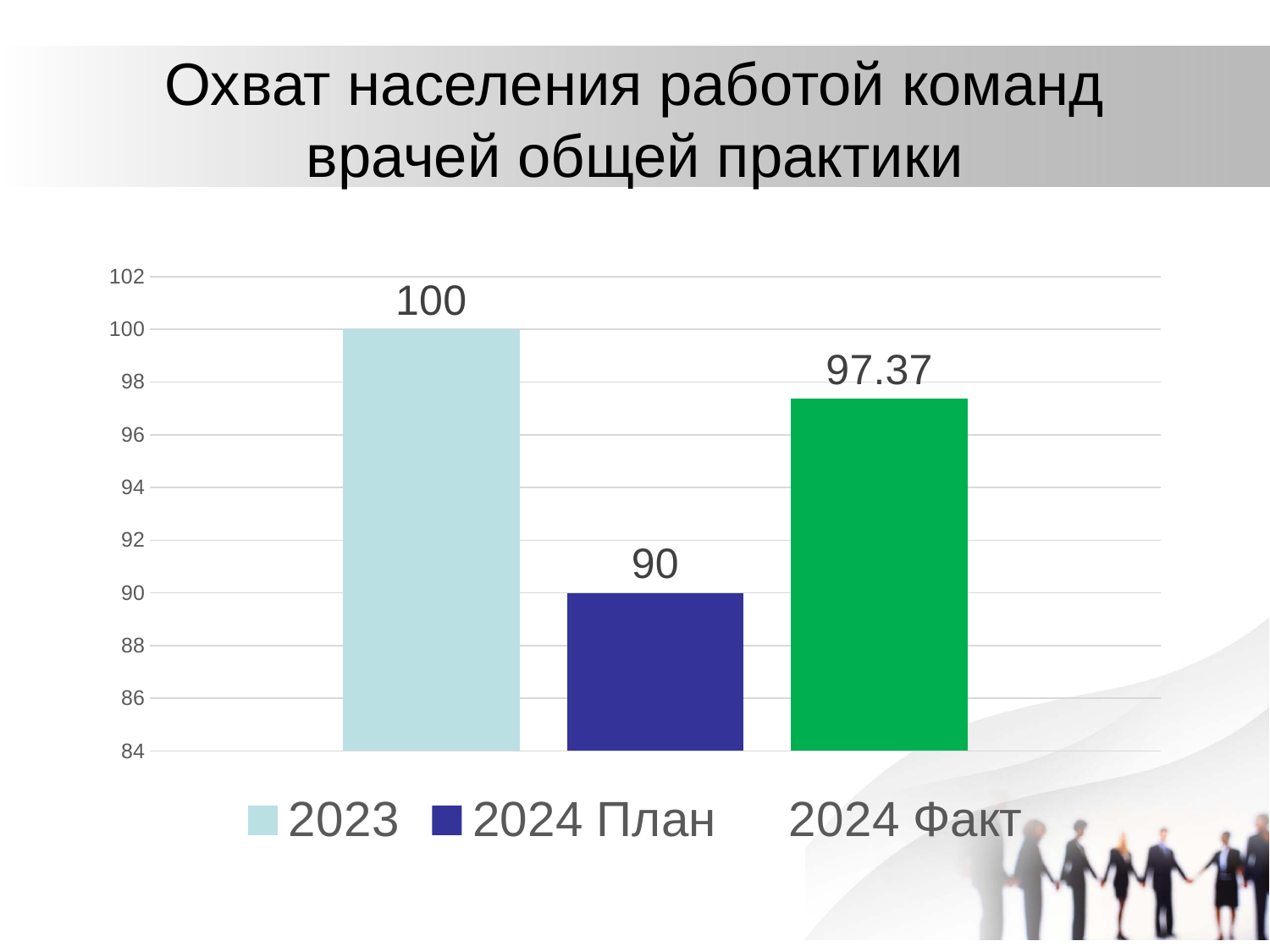
Which is larger, the value for 2024 Факт or the value for 2024 План? 2024 Факт What is the difference between the 2024 Факт value and the 2024 План value? 7.37 What is the value for 2024 План? 90 Which series has the lowest value? 2024 План How many bars are plotted on the chart? 3 What kind of chart is shown on the slide? bar chart What is the value for 2023? 100 What is the value for 2024 Факт? 97.37 What is the difference between the 2023 value and the 2024 План value? 10 How many series does the legend list? 3 Is the value for 2024 Факт greater or less than 96? greater Which series has the highest value? 2023